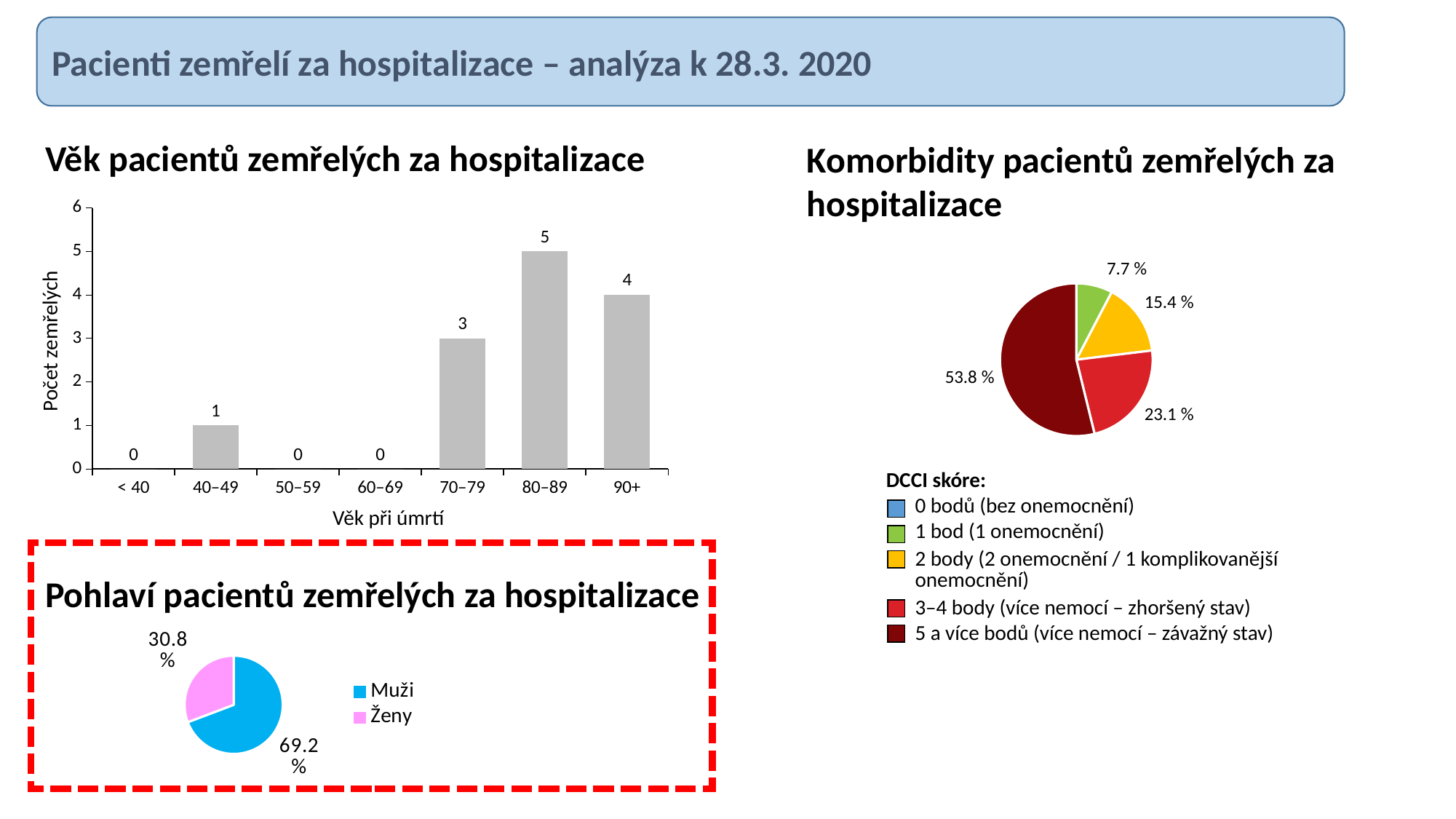
In the chart 'Věk pacientů zemřelých za hospitalizace', which age group has the highest number of deaths? 80–89 How many entries does the DCCI skóre legend list for the chart 'Komorbidity pacientů zemřelých za hospitalizace'? 5 In the pie chart 'Pohlaví pacientů zemřelých za hospitalizace', what share is labelled for Muži? 69.2 % In the pie chart 'Pohlaví pacientů zemřelých za hospitalizace', what share is labelled for Ženy? 30.8 % What type of chart is 'Věk pacientů zemřelých za hospitalizace'? Bar chart In the pie chart 'Komorbidity pacientů zemřelých za hospitalizace', what share is shown for the yellow slice (2 body)? 15.4 % In the chart 'Věk pacientů zemřelých za hospitalizace', what is the difference between the number of deaths in the 80–89 group and the 70–79 group? 2 In the chart 'Věk pacientů zemřelých za hospitalizace', how many deaths are shown for the 40–49 age group? 1 In the chart 'Věk pacientů zemřelých za hospitalizace', how many deaths are shown for the 80–89 age group? 5 In the chart 'Věk pacientů zemřelých za hospitalizace', which has more deaths: the 90+ group or the 70–79 group? 90+ In the pie chart 'Komorbidity pacientů zemřelých za hospitalizace', what is the largest slice's share? 53.8 % How many age categories are shown on the x axis of the chart 'Věk pacientů zemřelých za hospitalizace'? 7